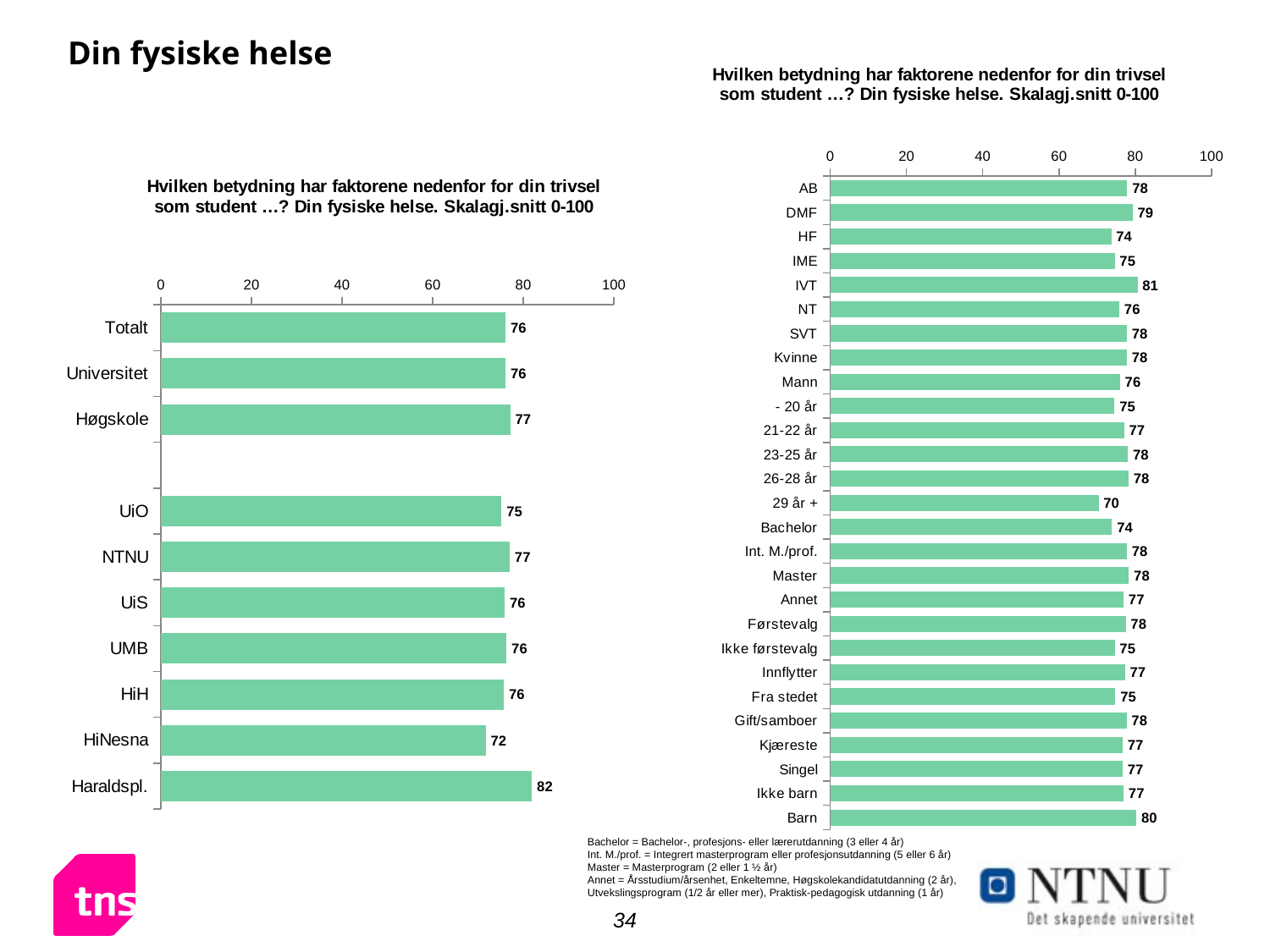
On the left chart, how many categories are plotted? 10 On the left chart, which category has the highest value? Haraldspl. On the right chart, which category has the highest value? IVT On the right chart, which category has the lowest value? 29 år + On the right chart, which is larger, the value for Barn or the value for Bachelor? Barn On the left chart, what is the value for HiNesna? 72 On the right chart, what is the value for 29 år +? 70 What kind of chart is the right chart? Bar chart On the left chart, what is the value for Haraldspl.? 82 On the left chart, which category has the lowest value? HiNesna On the right chart, what is the value for IVT? 81 On the left chart, what is the difference between Haraldspl. and HiNesna? 10